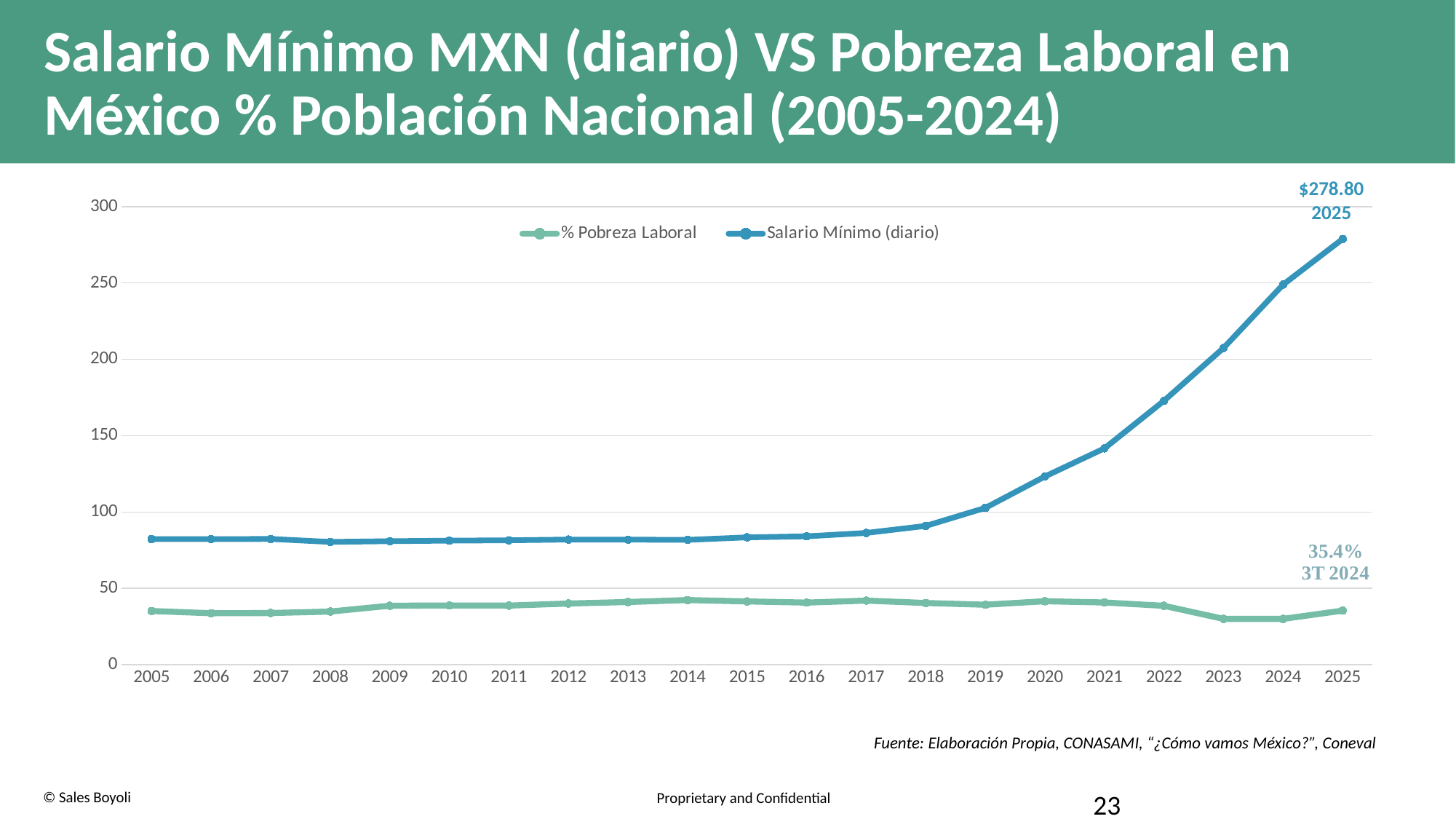
Is the value for % Pobreza Laboral in 2023 greater or less than 50? less Which year has the highest Salario Mínimo (diario) value? 2025 What kind of chart is shown on the slide? Line chart How many series does the legend list? 2 Does the Salario Mínimo (diario) line rise or fall from 2018 to 2025? rise Which series is drawn in blue? Salario Mínimo (diario) What is the labelled value of Salario Mínimo (diario) for 2025? $278.80 What value is annotated for % Pobreza Laboral at 3T 2024? 35.4% How many years are plotted along the x axis? 21 Is the value for Salario Mínimo (diario) in 2024 greater or less than 200? greater Is the value for Salario Mínimo (diario) in 2015 greater or less than 100? less